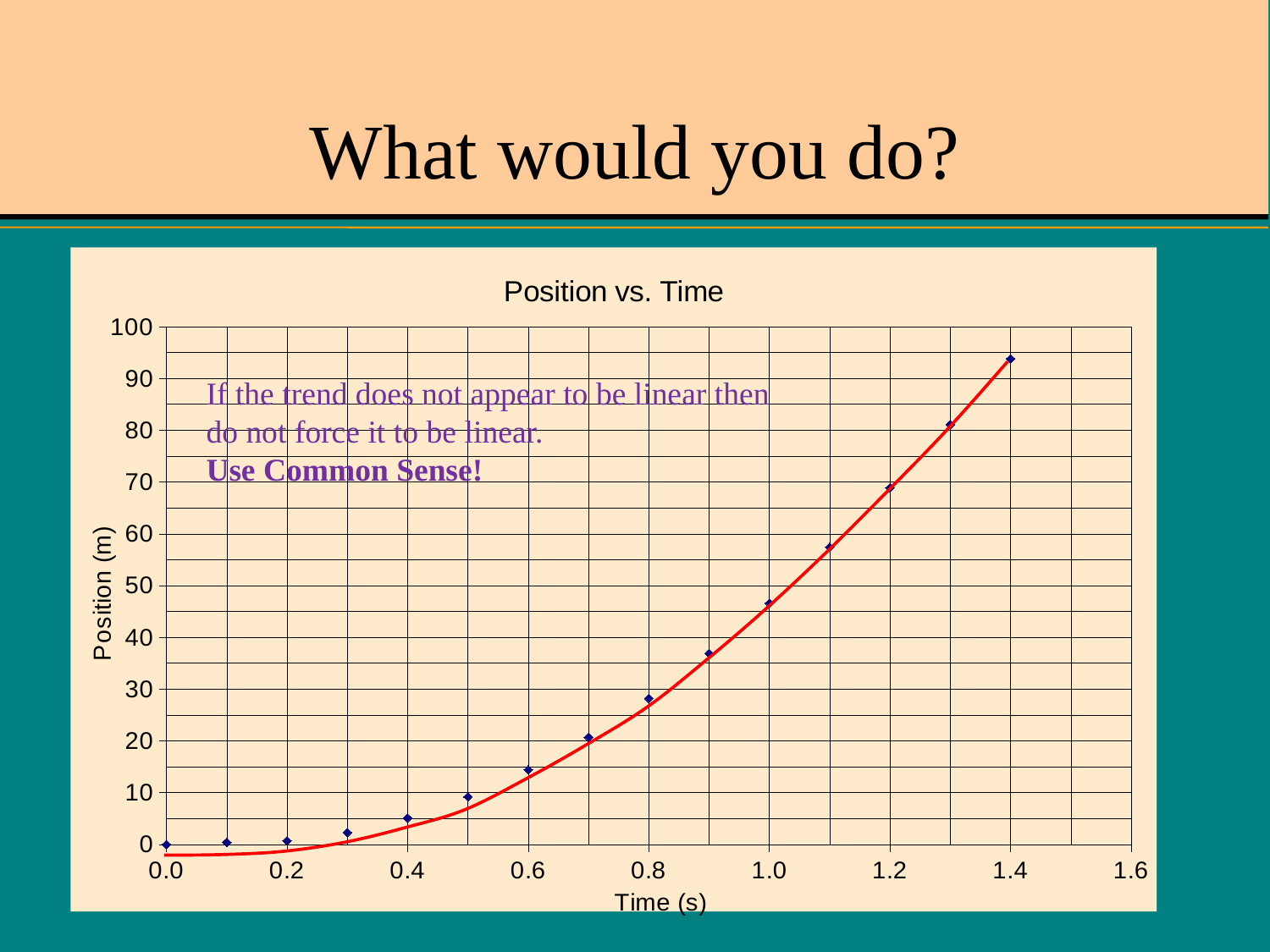
At which time is the position lowest? 0.0 Which has the larger position value, the point at 0.8 s or the point at 1.1 s? 1.1 s How many data points are plotted on the chart? 15 Is the position value at 1.2 s greater or less than 60? greater Is the position value at 0.6 s greater or less than 10? greater What is the title of the chart? Position vs. Time What kind of chart is shown on the slide? scatter plot Do the position values rise or fall as time increases along the x axis? rise Is the position value at 1.4 s greater or less than 90? greater At which time is the position highest? 1.4 What is the label of the x axis? Time (s)